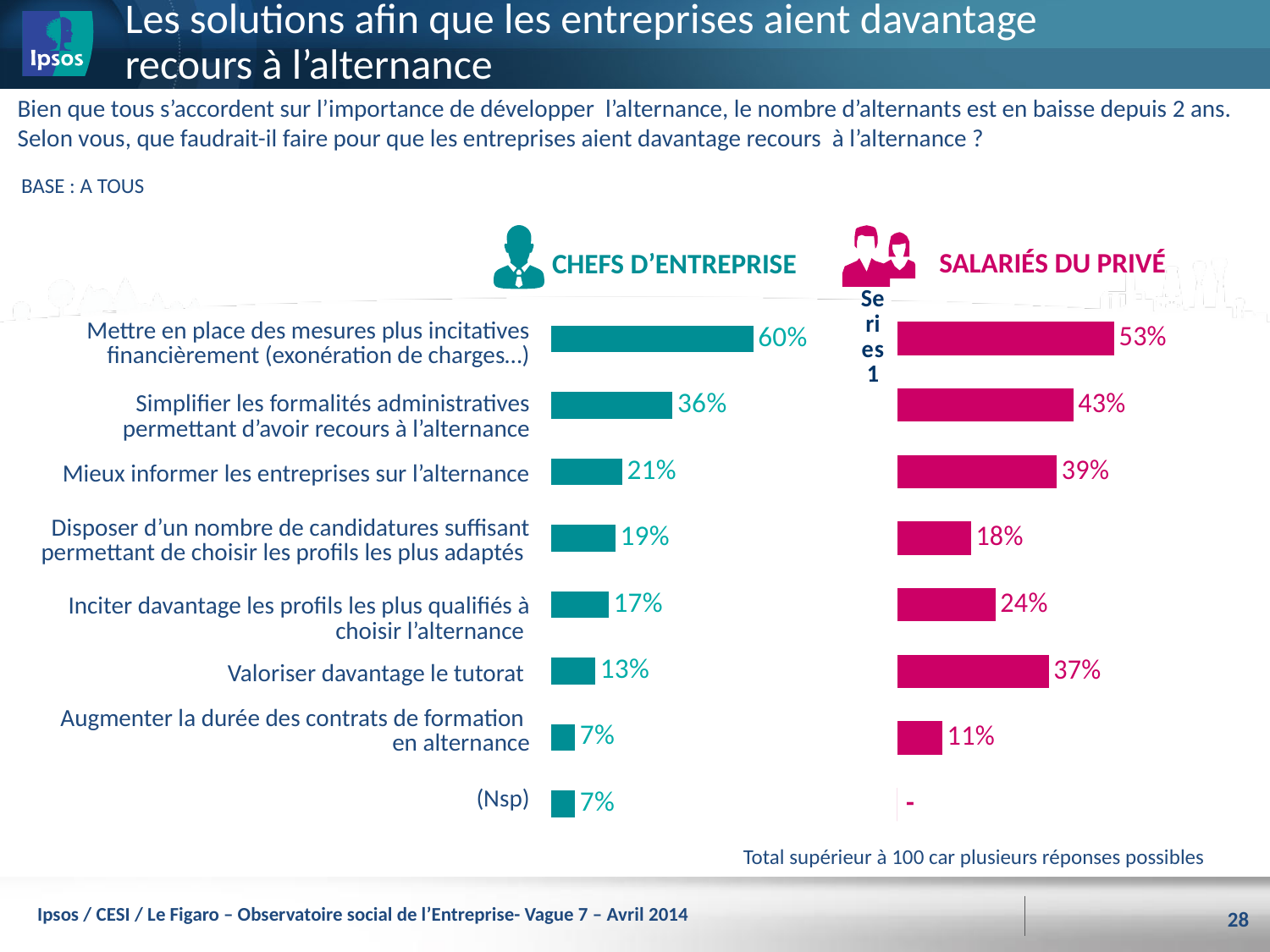
In the CHEFS D'ENTREPRISE chart, what is the value for "(Nsp)"? 7% What colour are the bars in the SALARIÉS DU PRIVÉ chart? Pink In the SALARIÉS DU PRIVÉ chart, which category has the lowest value among those with a percentage shown? Augmenter la durée des contrats de formation en alternance How many categories are listed in the CHEFS D'ENTREPRISE chart? 8 In the SALARIÉS DU PRIVÉ chart, what is the value for "Valoriser davantage le tutorat"? 37% For "Simplifier les formalités administratives permettant d'avoir recours à l'alternance", which group has the larger value: CHEFS D'ENTREPRISE or SALARIÉS DU PRIVÉ? SALARIÉS DU PRIVÉ In the CHEFS D'ENTREPRISE chart, what is the difference between "Mettre en place des mesures plus incitatives financièrement" and "Simplifier les formalités administratives"? 24 percentage points In the CHEFS D'ENTREPRISE chart, which category has the highest value? Mettre en place des mesures plus incitatives financièrement (exonération de charges…) What is the difference between the CHEFS D'ENTREPRISE value and the SALARIÉS DU PRIVÉ value for "Valoriser davantage le tutorat"? 24 percentage points In the SALARIÉS DU PRIVÉ chart, what is the value for "Mieux informer les entreprises sur l'alternance"? 39% What kind of chart is used to show the CHEFS D'ENTREPRISE results? Bar chart In the CHEFS D'ENTREPRISE chart, what is the value for "Mettre en place des mesures plus incitatives financièrement (exonération de charges…)"? 60%